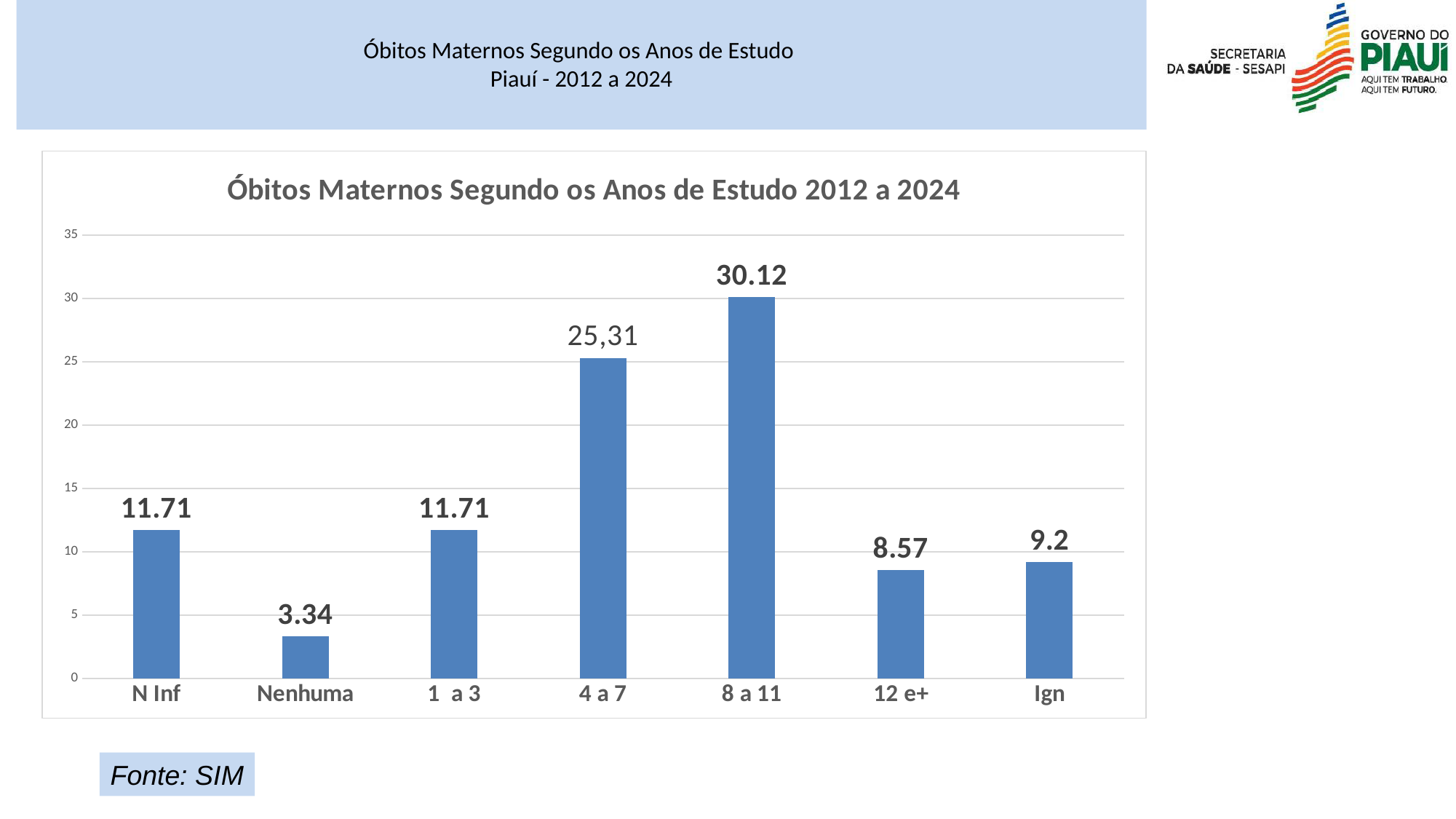
How many categories are shown on the x axis? 7 What is the difference between the values for 'Ign' and '12 e+'? 0.63 Which category has the lowest value? Nenhuma What is the difference between the values for 'N Inf' and 'Nenhuma'? 8.37 Which is larger, the value for '4 a 7' or the value for '12 e+'? 4 a 7 What is the value for the '8 a 11' category? 30.12 Is the value for '8 a 11' greater or less than 25? greater Which category has the highest value? 8 a 11 What is the value for the 'Nenhuma' category? 3.34 What kind of chart is shown on the slide? Bar chart What is the value for the 'Ign' category? 9.2 What is the value for the '4 a 7' category? 25,31